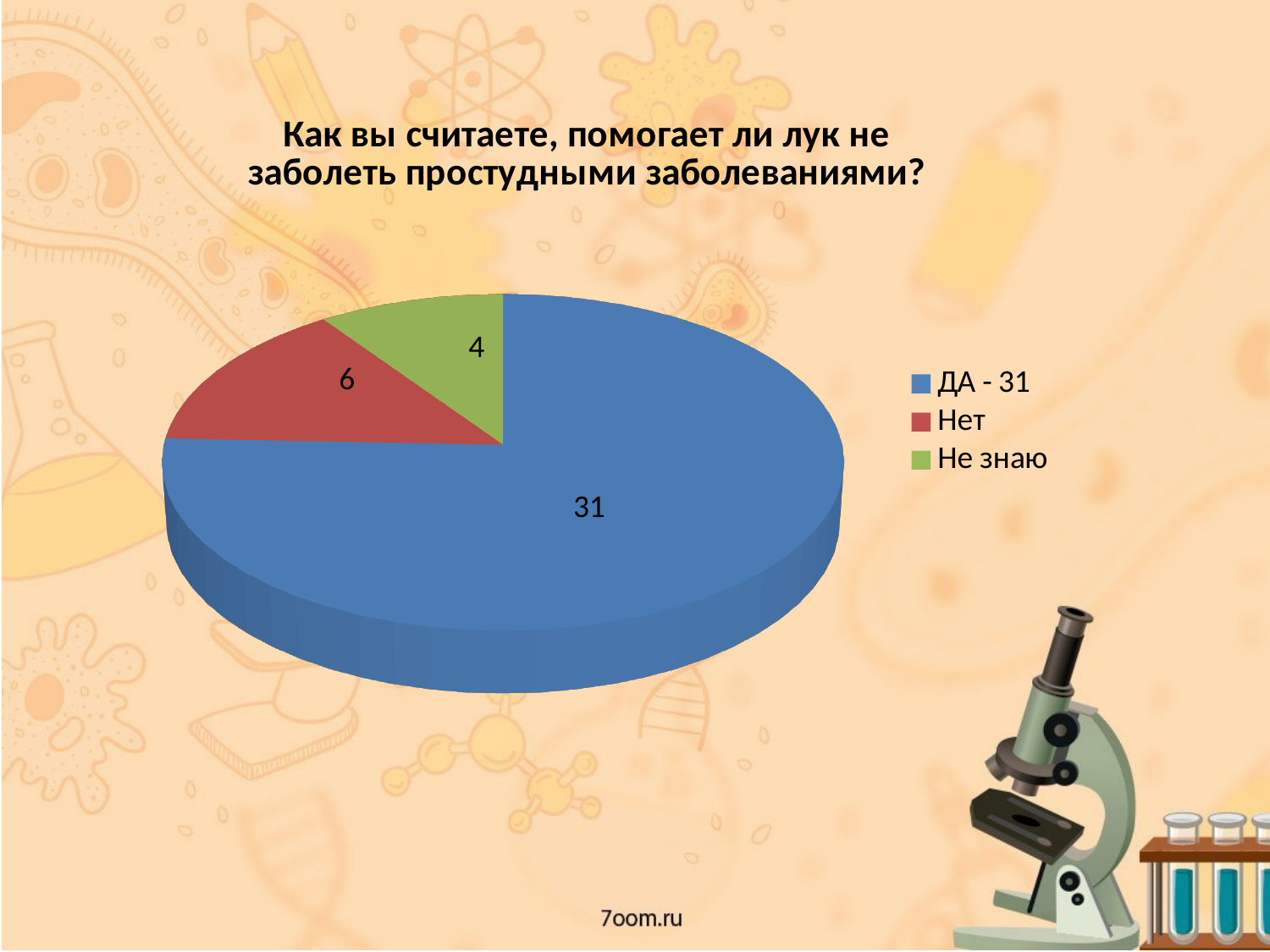
Which is larger, the "Нет" slice or the "Не знаю" slice? Нет What colour is the "Не знаю" slice? green Which category has the smallest slice? Не знаю What is the value for the "Нет" slice? 6 How many entries does the legend list? 3 Which category has the largest slice? ДА - 31 What is the value for the "ДА" slice? 31 What kind of chart is shown on the slide? pie chart How many slices does the pie chart have? 3 What is the difference between the "ДА" value and the "Нет" value? 25 What is the value for the "Не знаю" slice? 4 What is the difference between the "Нет" value and the "Не знаю" value? 2